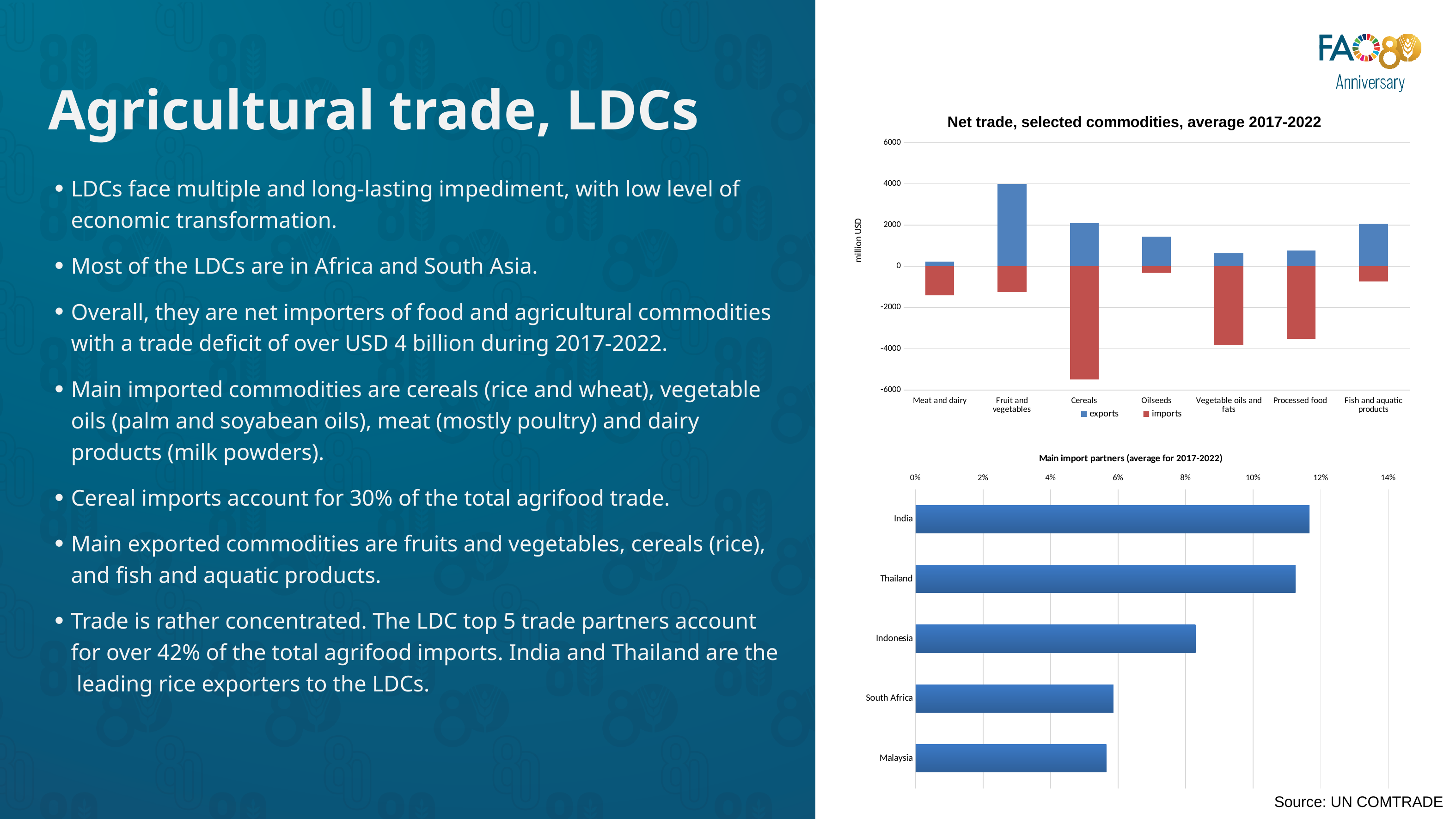
In the 'Net trade, selected commodities, average 2017-2022' chart, which commodity has the highest exports value? Fruit and vegetables How many series does the legend of the 'Net trade, selected commodities, average 2017-2022' chart list? 2 In the 'Main import partners (average for 2017-2022)' chart, is the value for Indonesia greater or less than 10%? less What is the y-axis label of the 'Net trade, selected commodities, average 2017-2022' chart? million USD In the 'Net trade, selected commodities, average 2017-2022' chart, is the exports value for Fruit and vegetables greater or less than 2000? greater In the 'Net trade, selected commodities, average 2017-2022' chart, is the imports value for Cereals greater or less than -4000? less In the 'Net trade, selected commodities, average 2017-2022' chart, which has the larger exports value, Fruit and vegetables or Cereals? Fruit and vegetables What kind of chart is the 'Net trade, selected commodities, average 2017-2022' chart? bar chart How many commodity categories are shown in the 'Net trade, selected commodities, average 2017-2022' chart? 7 How many countries are shown in the 'Main import partners (average for 2017-2022)' chart? 5 In the 'Main import partners (average for 2017-2022)' chart, which has the larger value, Thailand or Indonesia? Thailand In the 'Net trade, selected commodities, average 2017-2022' chart, which commodity has the largest imports bar (most negative value)? Cereals